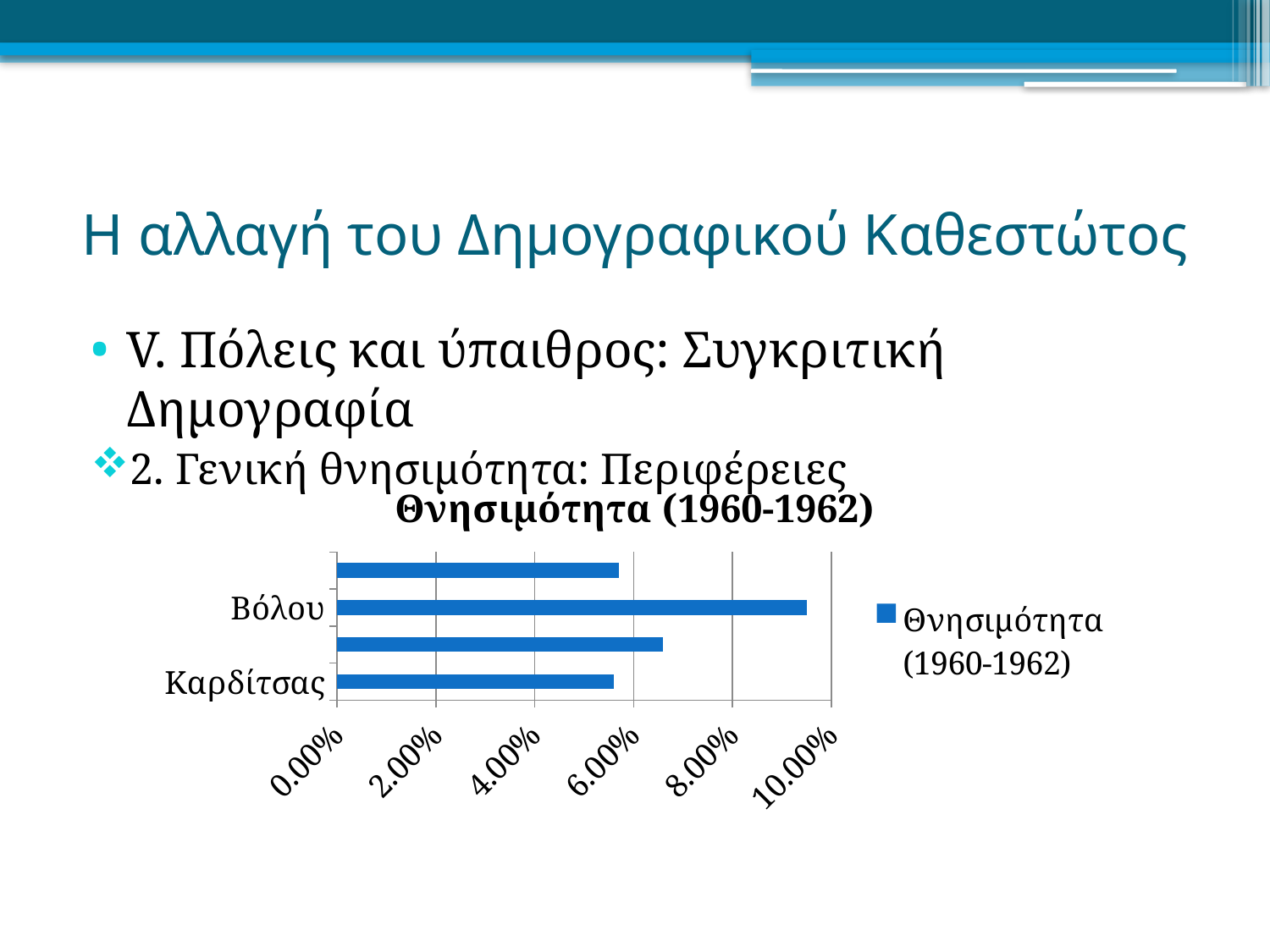
What is the title of the chart? Θνησιμότητα (1960-1962) What is the name of the series shown in the legend? Θνησιμότητα (1960-1962) What kind of chart is shown on the slide? bar chart Which is larger, the value for Βόλου or the value for Καρδίτσας? Βόλου Is the value for Βόλου greater or less than 8.00%? greater What is the highest value shown on the x axis of the chart? 10.00% Is the value for Καρδίτσας greater or less than 6.00%? less How many bars are plotted in the chart? 4 How many series does the legend list? 1 Is the value for Καρδίτσας greater or less than 4.00%? greater Which labelled category has the highest value in the chart? Βόλου